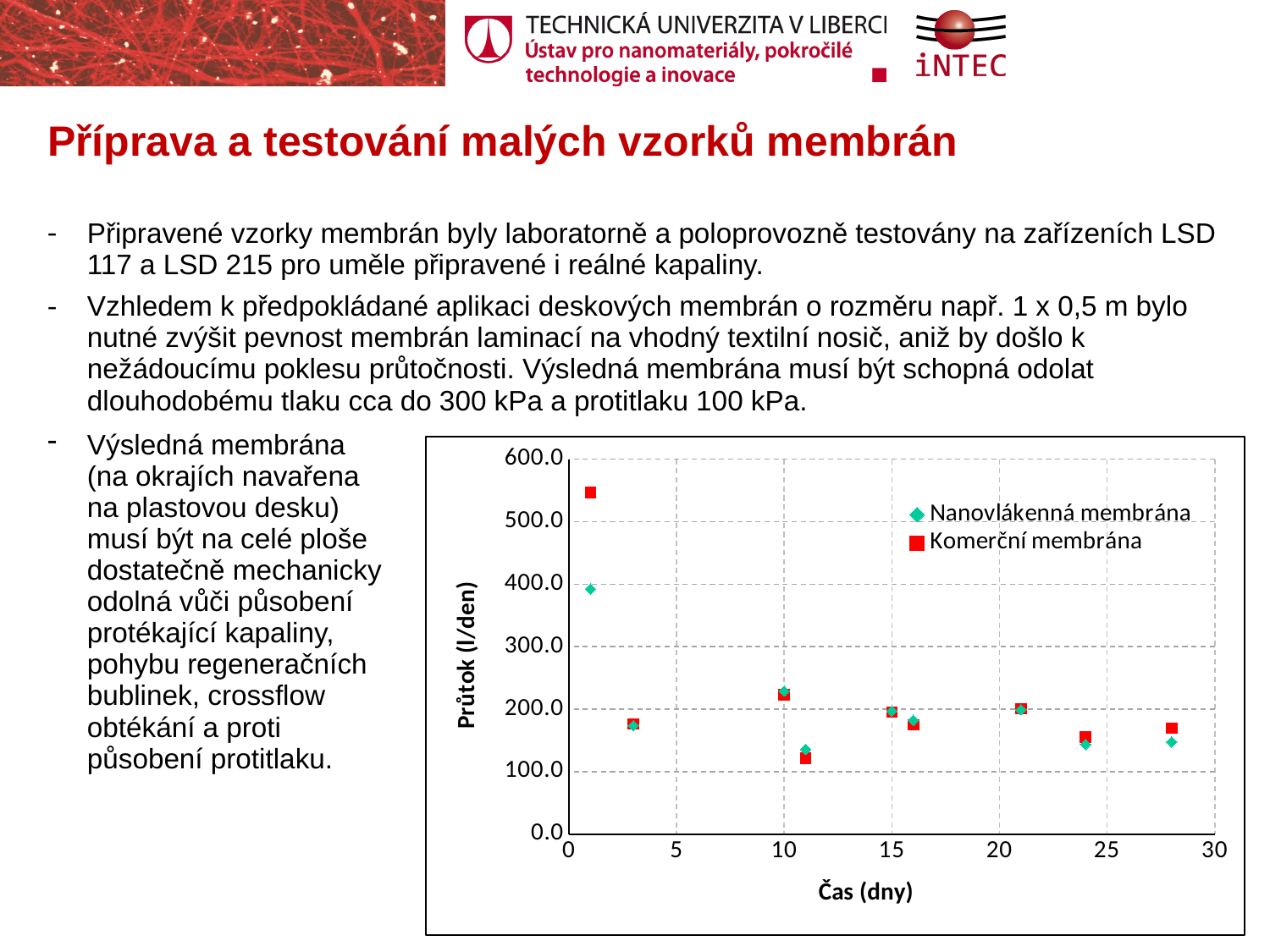
Overall, does the flow for Komerční membrána rise or fall from day 1 to day 28? fall Is the value for Nanovlákenná membrána at day 10 greater or less than 300? less What are the two series named in the chart legend? Nanovlákenná membrána and Komerční membrána How many series does the chart legend list? 2 How many data points are plotted for the Nanovlákenná membrána series? 9 At day 28, which series has the higher flow value, Nanovlákenná membrána or Komerční membrána? Komerční membrána Is the value for Komerční membrána at day 1 greater or less than 500? greater What is the title of the vertical axis of the chart? Průtok (l/den) Is the value for Komerční membrána at day 11 greater or less than 200? less What kind of chart is shown on the slide? scatter chart At day 1, which series has the higher flow value, Nanovlákenná membrána or Komerční membrána? Komerční membrána